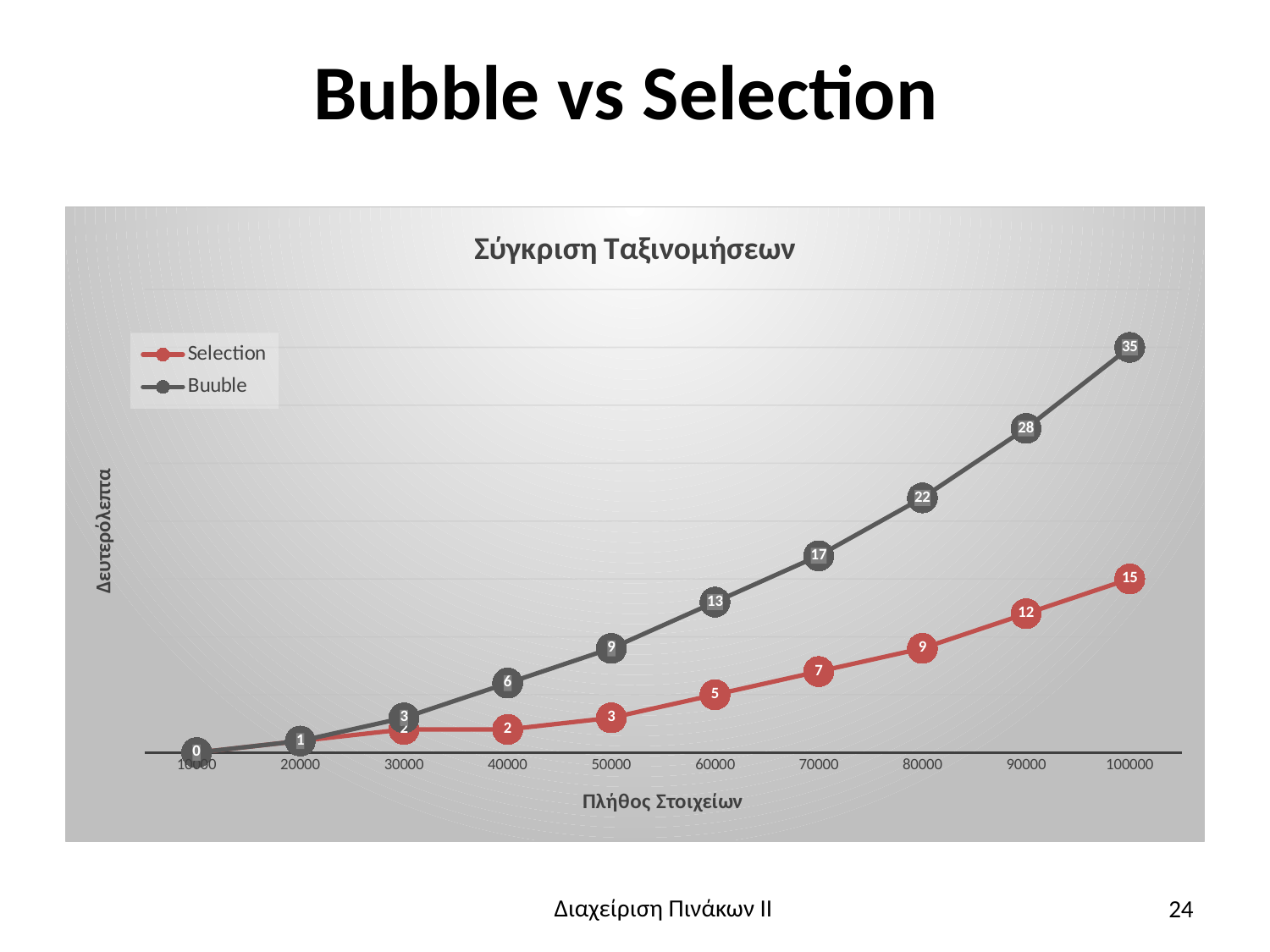
What is the value for Buuble at 100000? 35 Which series has the larger value at 90000, Selection or Buuble? Buuble What is the value for Selection at 70000? 7 At which x-axis value does the Buuble series reach its highest value? 100000 How many series does the legend list? 2 What is the value for Selection at 100000? 15 What is the difference between Buuble and Selection at 100000? 20 Do the values of the Buuble series rise or fall as the number of elements increases along the x axis? rise What is the title of the chart? Σύγκριση Ταξινομήσεων What is the difference between Buuble and Selection at 80000? 13 What kind of chart is shown? line chart What is the value for Buuble at 60000? 13